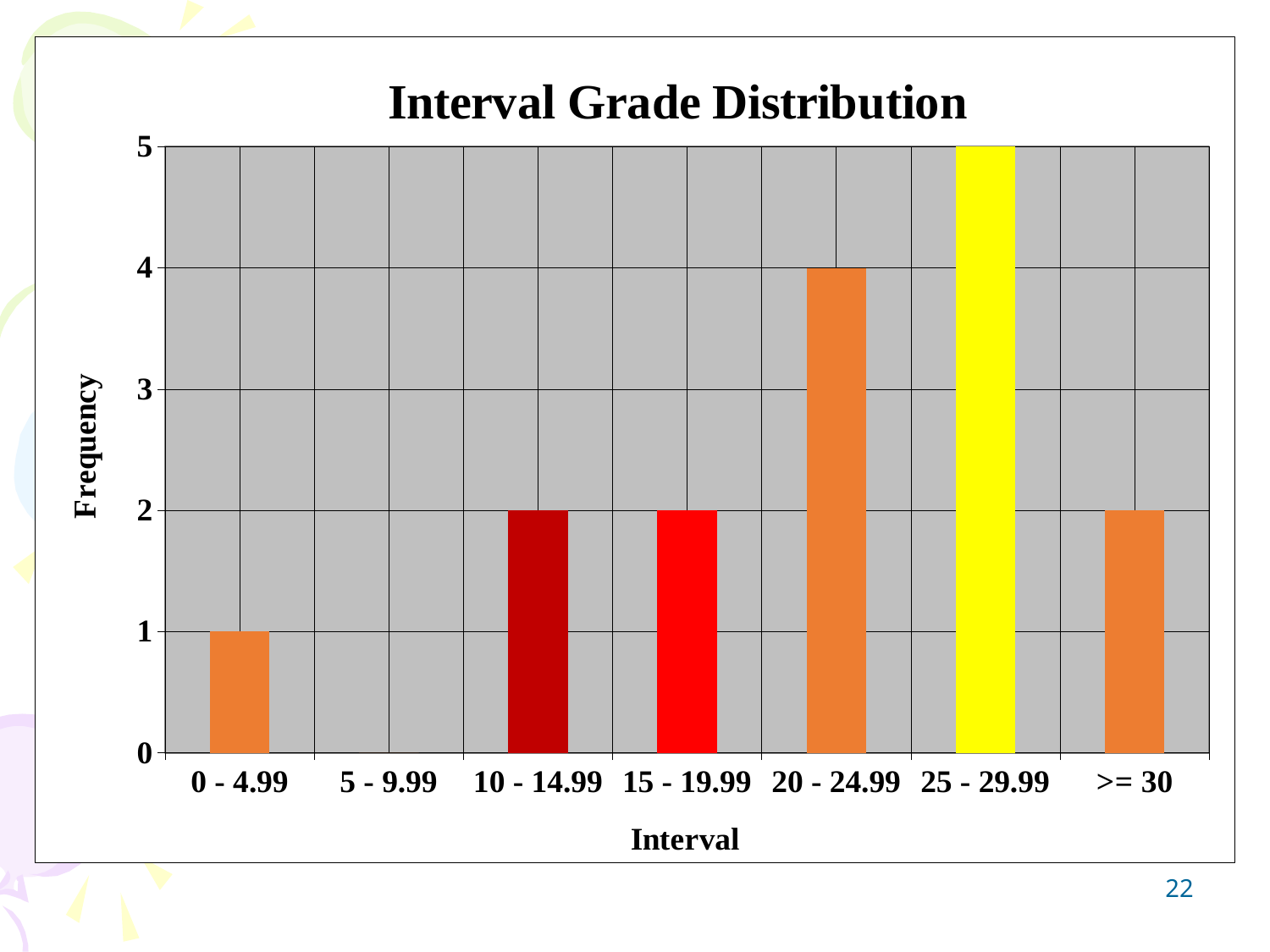
What is the frequency for the 5 - 9.99 interval? 0 Which has a higher frequency, the 10 - 14.99 interval or the 20 - 24.99 interval? 20 - 24.99 How many intervals are shown on the x axis? 7 What is the frequency for the >= 30 interval? 2 What is the difference in frequency between the 25 - 29.99 interval and the 20 - 24.99 interval? 1 What is the frequency for the 0 - 4.99 interval? 1 What is the frequency for the 20 - 24.99 interval? 4 Which interval has the highest frequency? 25 - 29.99 What is the frequency for the 25 - 29.99 interval? 5 What kind of chart is shown on the slide? Bar chart Which interval has the lowest frequency? 5 - 9.99 What is the title of the chart? Interval Grade Distribution